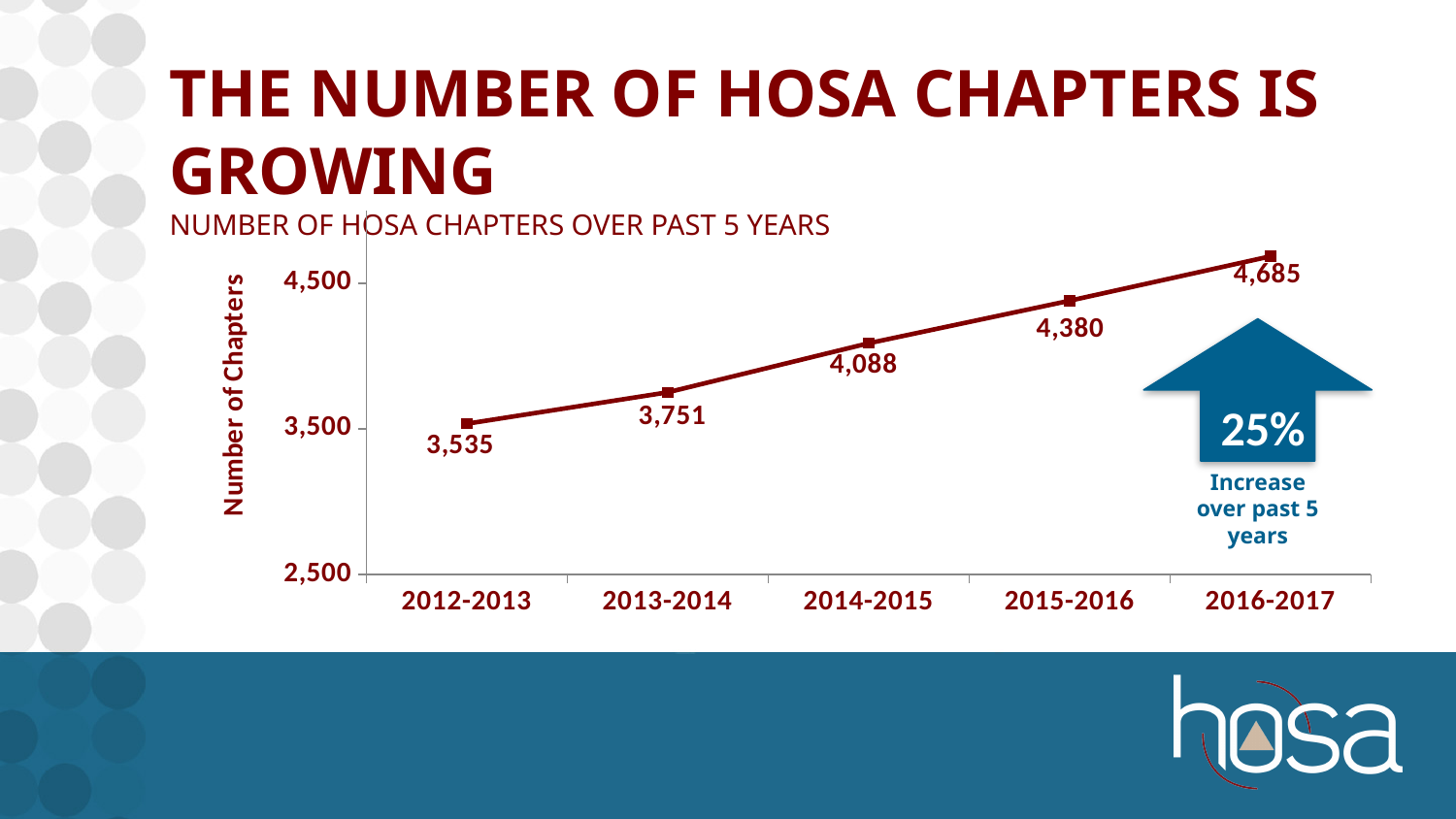
How many years are plotted on the chart? 5 Which year has more chapters, 2013-2014 or 2015-2016? 2015-2016 Do the values rise or fall from 2012-2013 to 2016-2017? rise Is the value for 2013-2014 greater or less than 3,500? greater What is the number of HOSA chapters in 2012-2013? 3,535 What is the number of HOSA chapters in 2014-2015? 4,088 Which year has the highest number of HOSA chapters? 2016-2017 What is the difference in the number of chapters between 2015-2016 and 2014-2015? 292 Which year has the lowest number of HOSA chapters? 2012-2013 What kind of chart is shown on the slide? line chart What is the number of HOSA chapters in 2016-2017? 4,685 What is the difference in the number of chapters between 2016-2017 and 2012-2013? 1,150